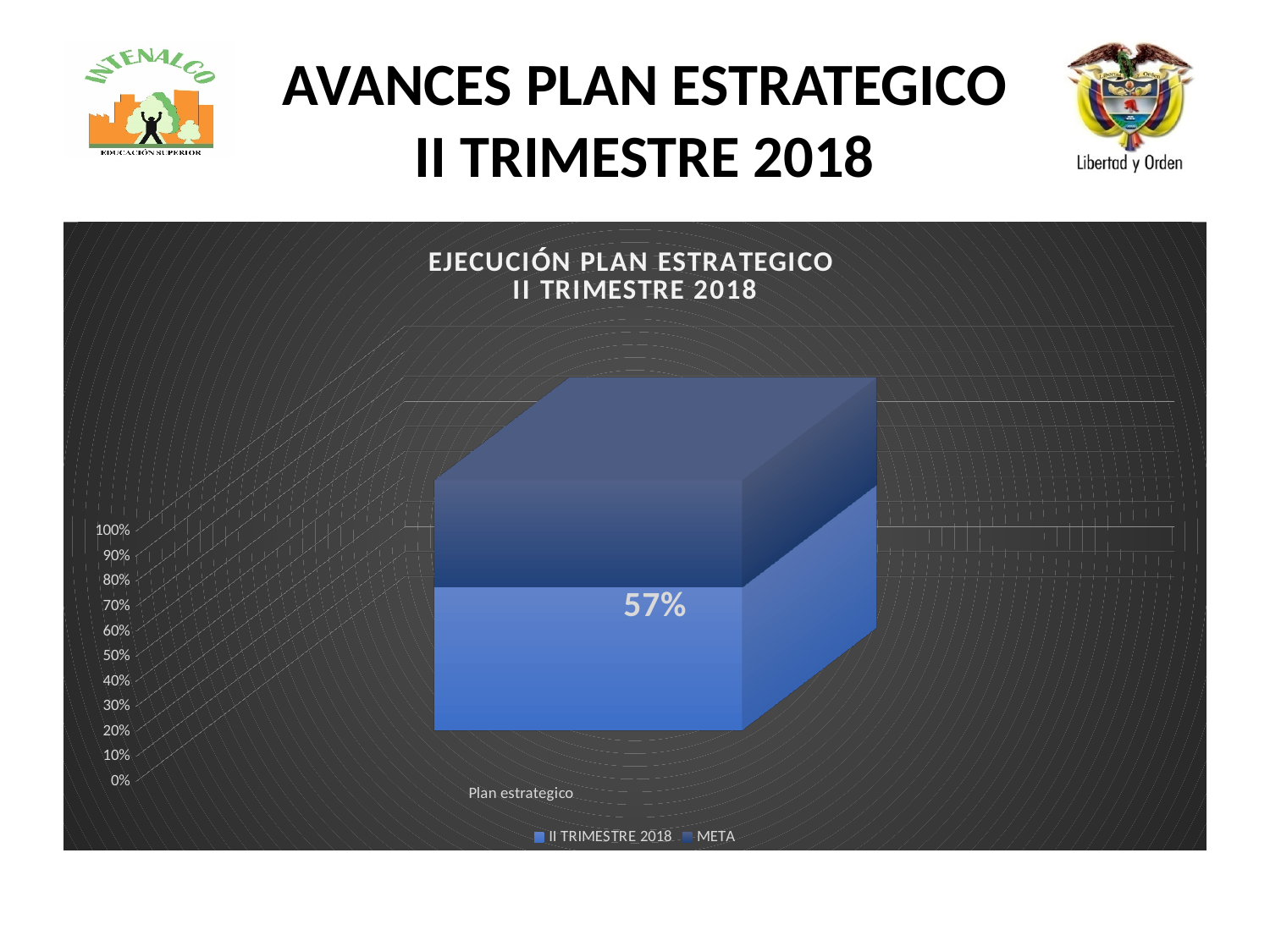
What kind of chart is shown on the slide? bar chart What are the two series named in the chart legend? II TRIMESTRE 2018 and META What is the name of the single category on the x axis? Plan estrategico Is the value for II TRIMESTRE 2018 greater or less than 60%? less What is the highest value shown on the y axis of the chart? 100% How many categories are shown on the x axis of the chart? 1 What is the title of the chart? EJECUCIÓN PLAN ESTRATEGICO II TRIMESTRE 2018 What is the value of the II TRIMESTRE 2018 series for Plan estrategico? 57% How many series does the chart legend list? 2 Is the value for II TRIMESTRE 2018 greater or less than 50%? greater